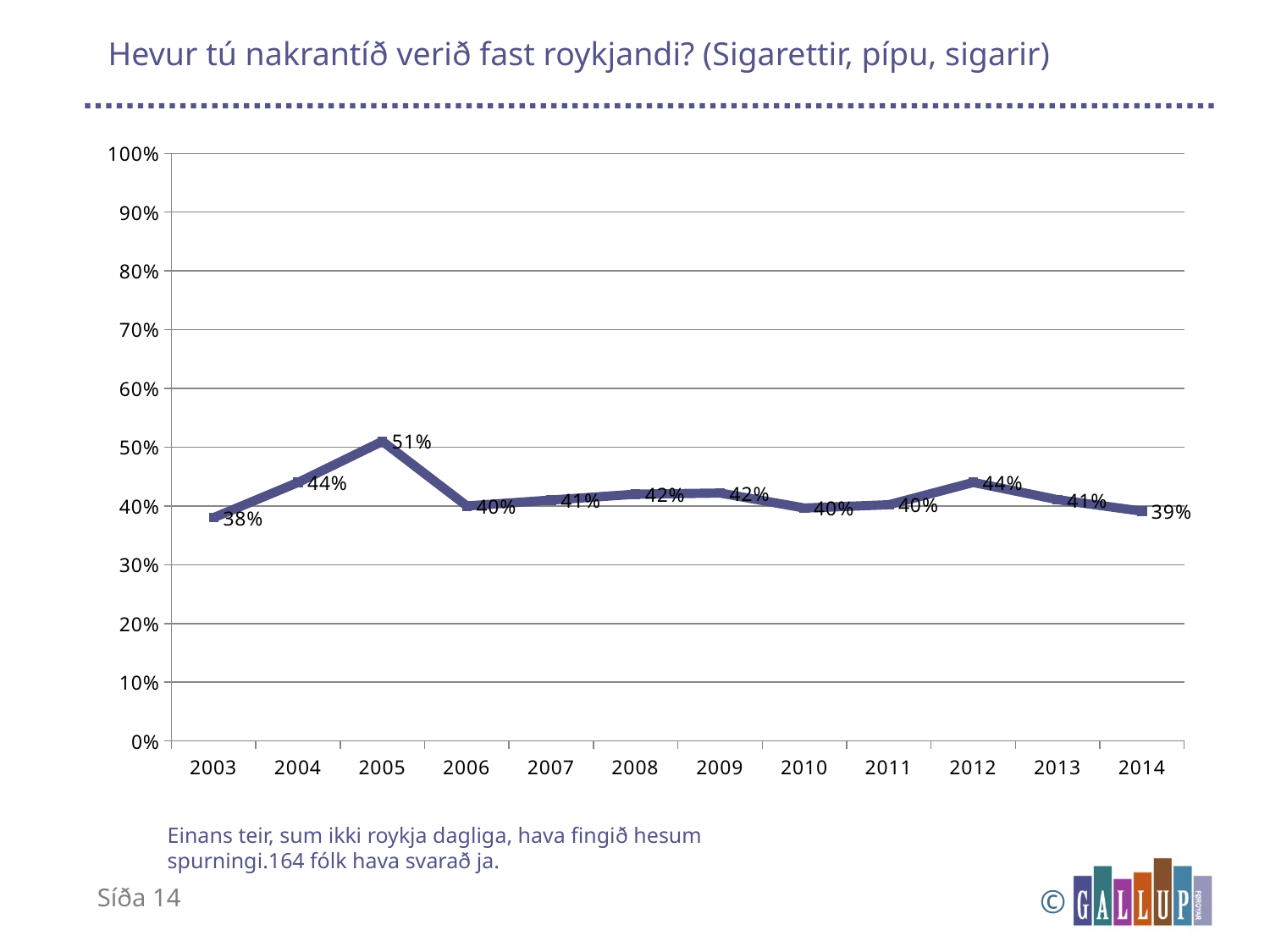
Which is larger, the value for 2004 or the value for 2010? 2004 How many years are plotted on the chart? 12 Which year has the lowest value? 2003 What is the value for 2005? 51% What is the value for 2003? 38% What is the value for 2012? 44% What kind of chart is shown on the slide? line chart Is the value for 2005 greater or less than 50%? greater What is the value for 2014? 39% Does the value rise or fall from 2012 to 2014? fall What is the difference between the values for 2005 and 2006? 11% Which year has the highest value? 2005